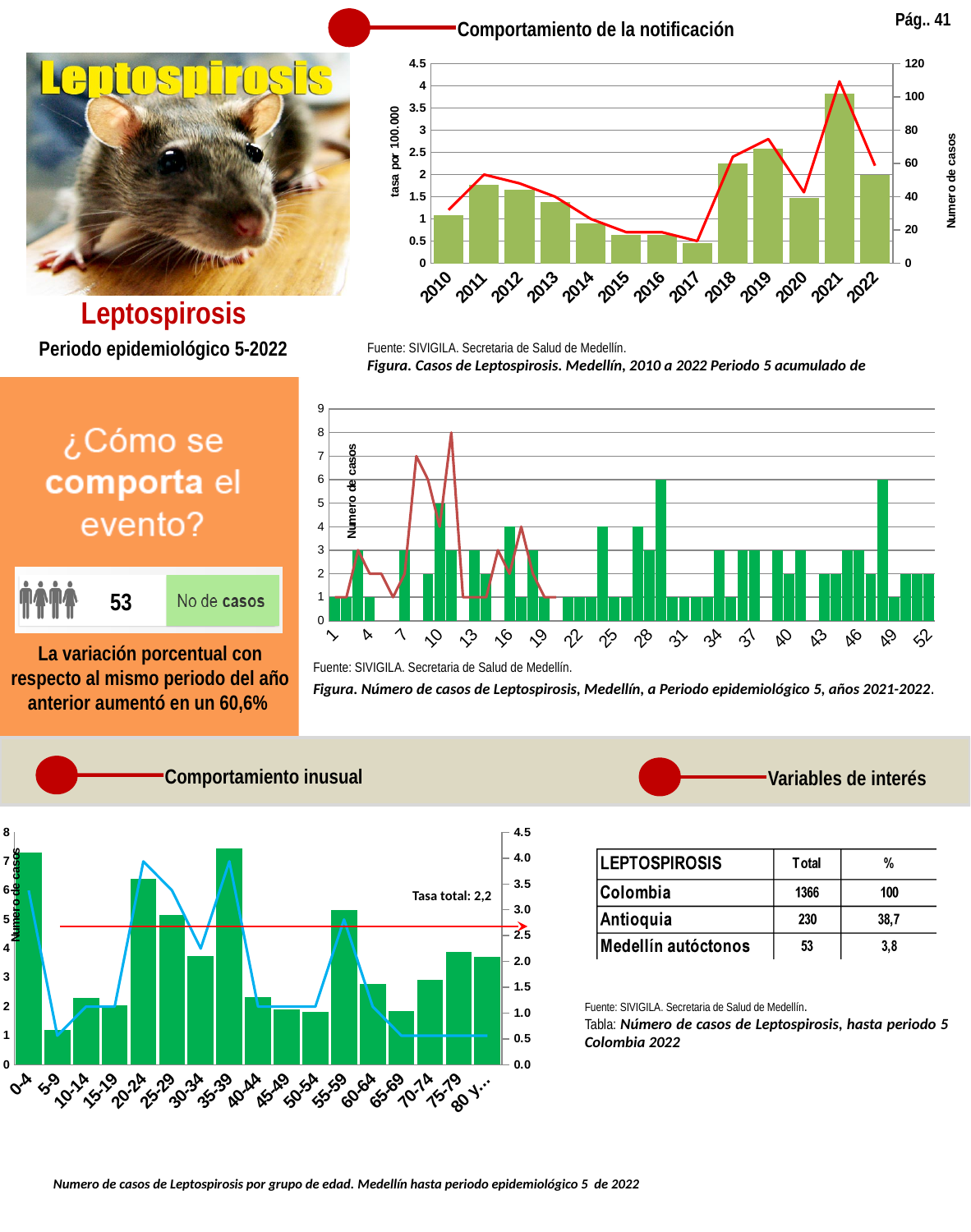
In the middle chart (Número de casos de Leptospirosis, Medellín, años 2021-2022), what is the highest value reached by the red line? 8 In the top chart (Casos de Leptospirosis, Medellín, 2010 a 2022), which year has the tallest bar? 2021 In the top chart (Casos de Leptospirosis, Medellín, 2010 a 2022), is the number of cases for 2018 greater or less than 40? greater In the top chart (Casos de Leptospirosis, Medellín, 2010 a 2022), is the number of cases for 2021 greater or less than 80? greater In the top chart (Casos de Leptospirosis, Medellín, 2010 a 2022), do the bars rise or fall from 2017 to 2021? rise In the top chart (Casos de Leptospirosis, Medellín, 2010 a 2022), what kind of chart is used? bar chart with a line In the top chart (Casos de Leptospirosis, Medellín, 2010 a 2022), which year has the shortest bar? 2017 In the bottom-left chart (casos por grupo de edad), what value is given for 'Tasa total'? 2,2 In the top chart (Casos de Leptospirosis, Medellín, 2010 a 2022), which bar is taller, 2019 or 2020? 2019 In the middle chart (Número de casos de Leptospirosis, Medellín, años 2021-2022), what is the highest value reached by the green bars? 6 In the bottom-left chart (casos por grupo de edad), which age group has the shortest bar? 5-9 In the top chart (Casos de Leptospirosis, Medellín, 2010 a 2022), how many years are shown on the x axis? 13